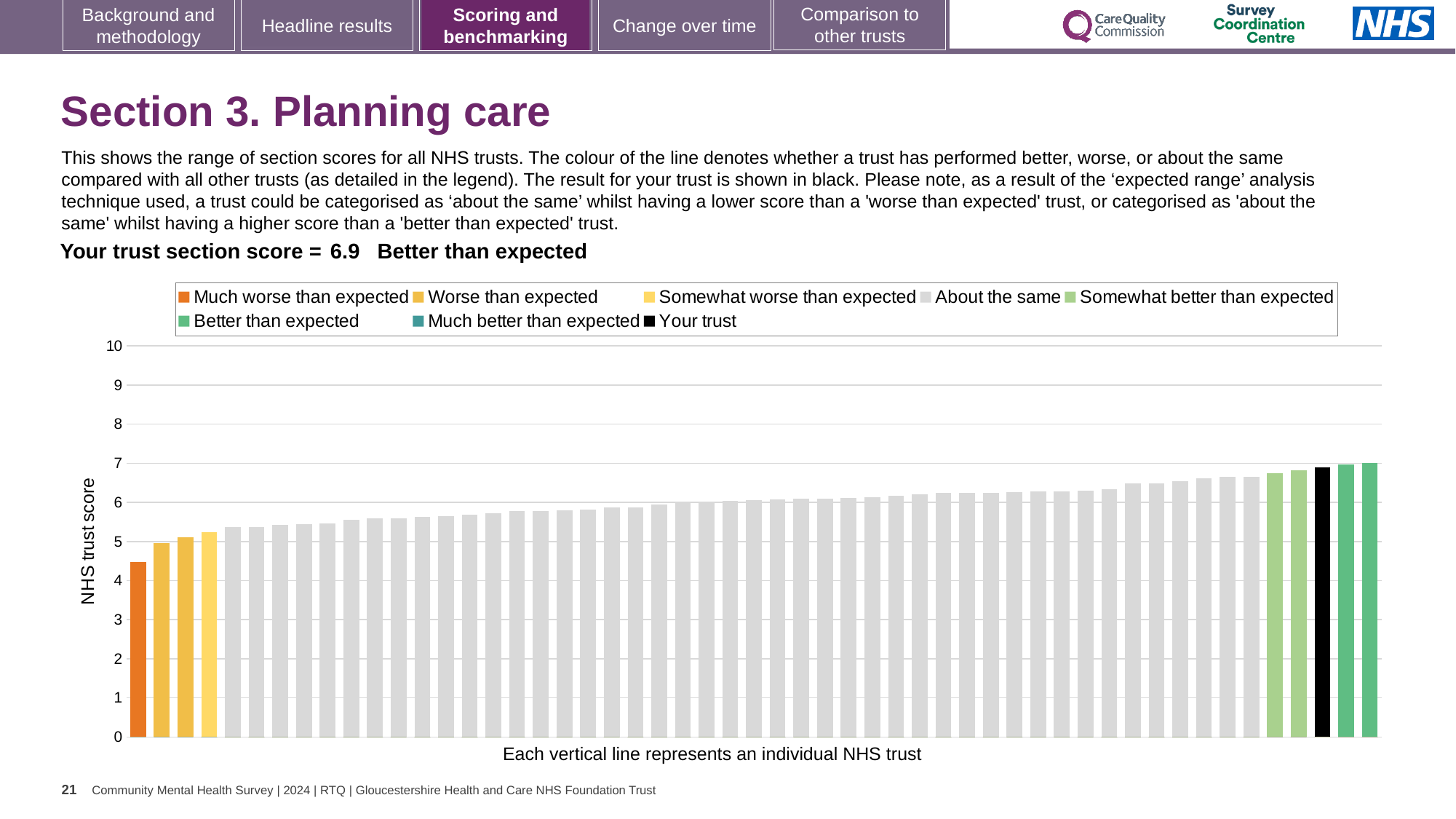
Is the tallest bar in the chart greater or less than 8? less Which performance category is your trust placed in for this section? Better than expected How many bars are coloured orange (Much worse than expected)? 1 Is the value of the orange 'Much worse than expected' bar greater or less than 5? less Do the bar values rise or fall from left to right along the x axis? rise What is the label on the vertical axis of the chart? NHS trust score What is the section score for your trust shown on the slide? 6.9 What type of chart is shown on the slide? bar chart Which is larger, the black 'Your trust' bar or the orange 'Much worse than expected' bar? the black 'Your trust' bar Is the value of the black 'Your trust' bar greater or less than 5? greater How many entries does the chart legend list? 8 What is the highest value shown on the vertical axis? 10